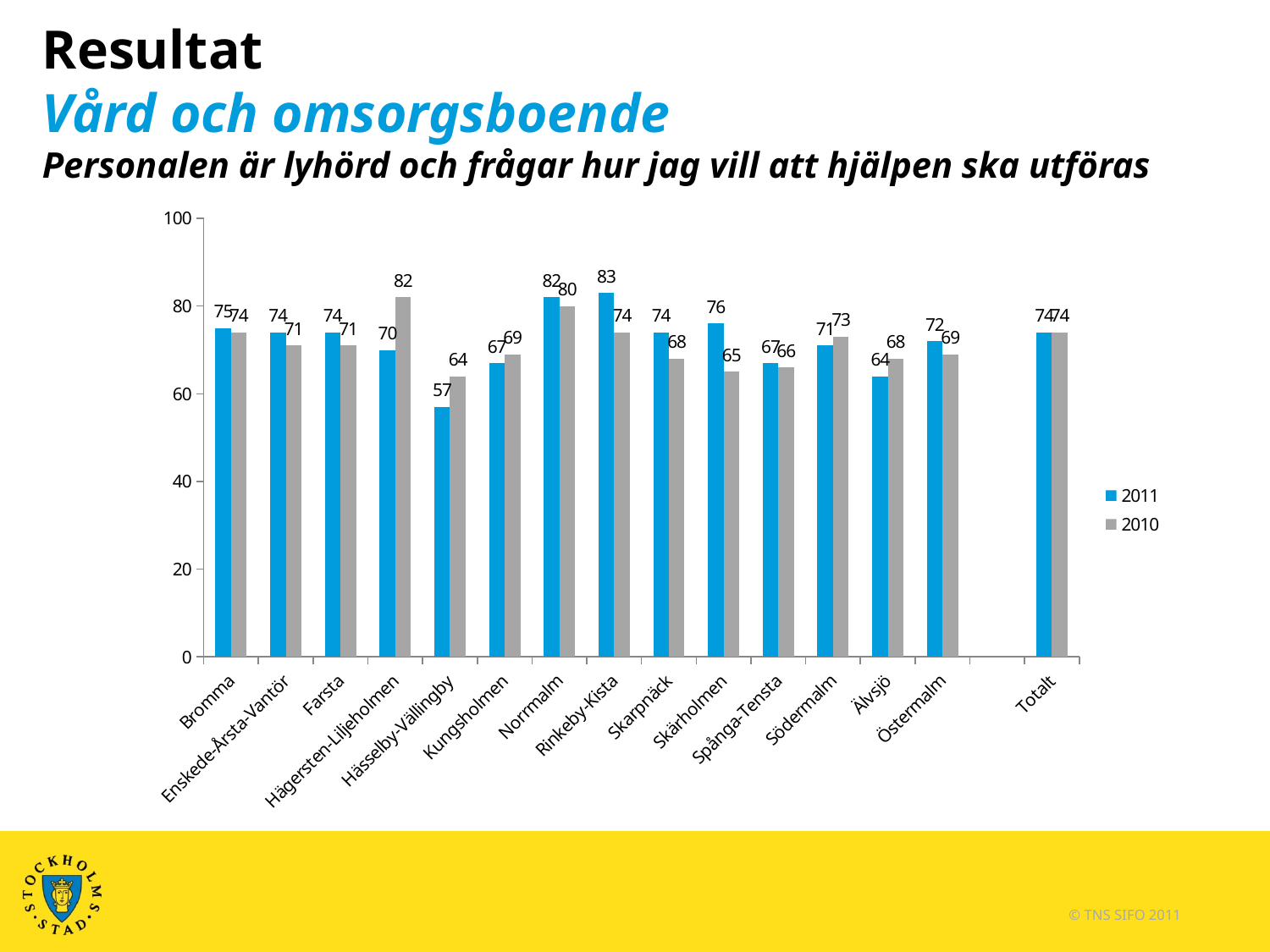
How many categories are shown on the x axis? 15 What kind of chart is shown on the slide? Bar chart How many series does the legend list? 2 Which category has the highest 2010 value? Hägersten-Liljeholmen Which category has the lowest 2011 value? Hässelby-Vällingby What is the 2011 value for Rinkeby-Kista? 83 Which category has the highest 2011 value? Rinkeby-Kista What is the 2011 value for Hässelby-Vällingby? 57 What is the difference between the 2011 and 2010 values for Skärholmen? 11 What is the 2011 value for Totalt? 74 Which is larger for Hägersten-Liljeholmen, the 2011 value or the 2010 value? 2010 What is the 2010 value for Hägersten-Liljeholmen? 82